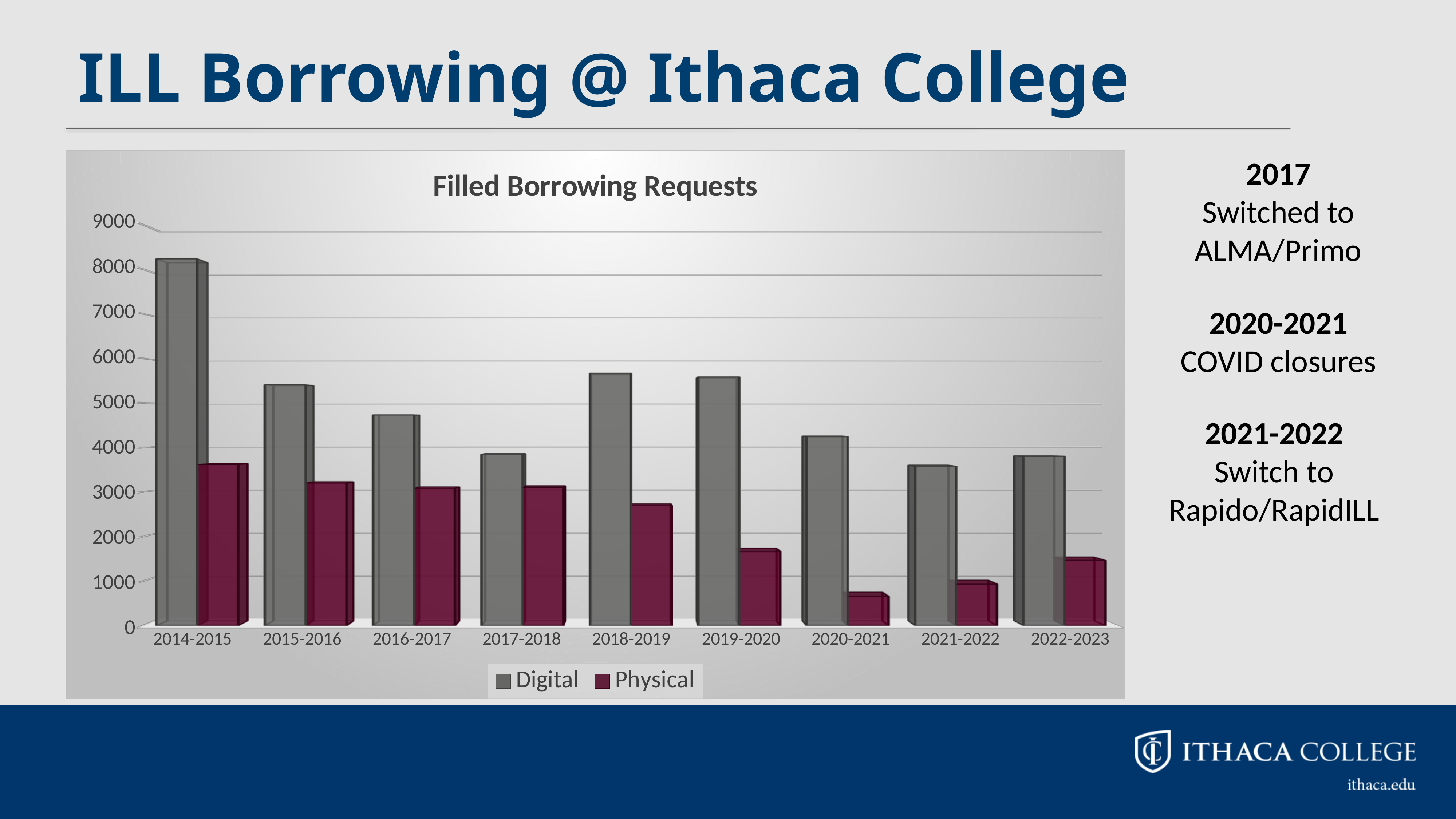
Which year has the highest Digital value? 2014-2015 Is the Digital value for 2018-2019 greater or less than 5000? greater Which year has the highest Physical value? 2014-2015 In 2014-2015, which is larger, the Digital value or the Physical value? Digital Is the Physical value for 2020-2021 greater or less than 1000? less What is the title of the chart? Filled Borrowing Requests Which series is shown in dark red in the chart? Physical How many series does the chart's legend list? 2 How many academic-year categories are shown on the x axis? 9 Which year has the lowest Physical value? 2020-2021 Is the Digital value for 2014-2015 greater or less than 7000? greater What kind of chart is shown on the slide? bar chart